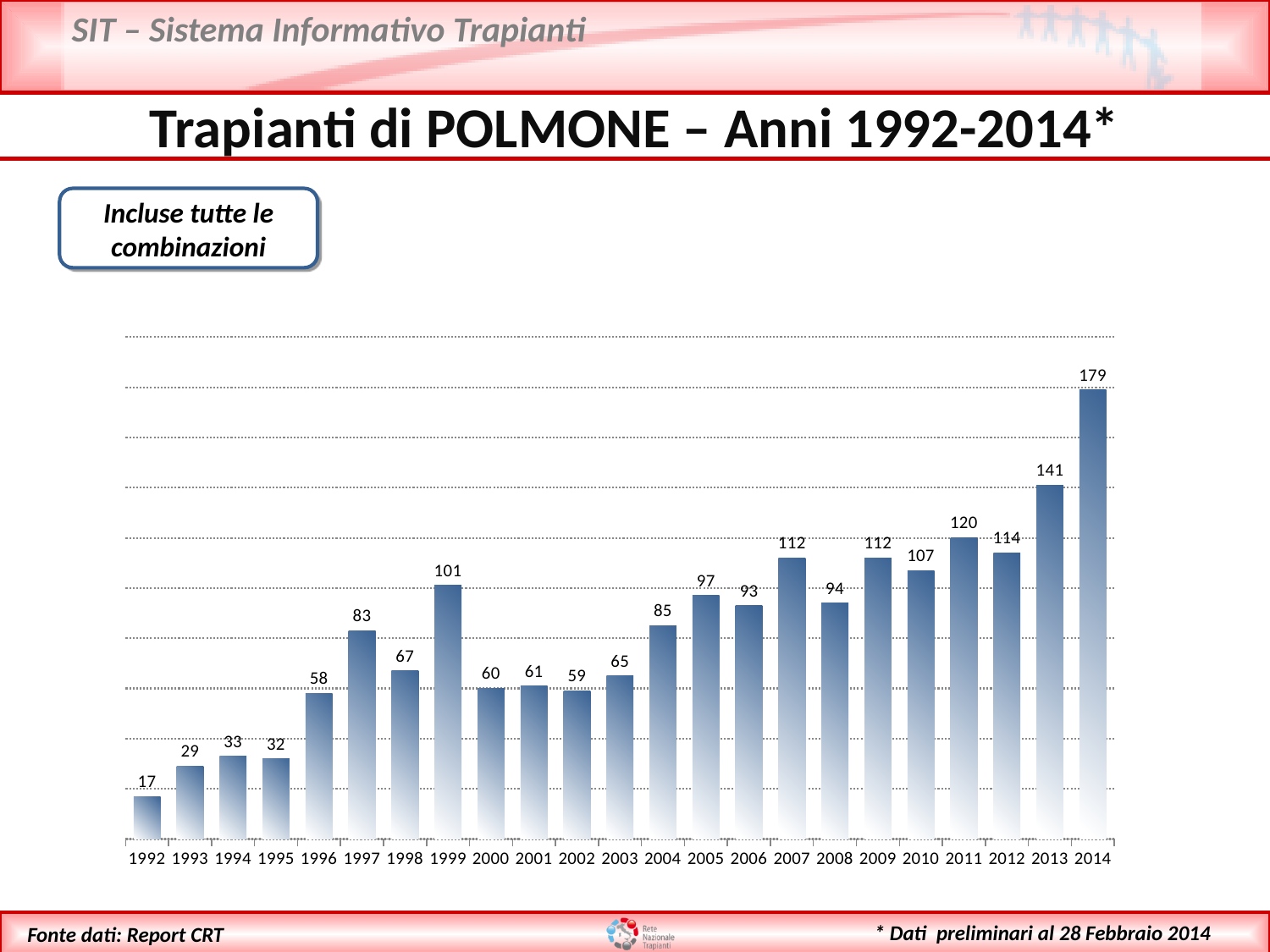
What is the difference between the values for 2011 and 2010? 13 Which year has the lowest value? 1992 What is the title of the slide containing the chart? Trapianti di POLMONE – Anni 1992-2014* What is the value for 1999? 101 What kind of chart is shown on the slide? bar chart What is the value for 2008? 94 Do the values generally rise or fall from 2009 to 2014? rise Which is larger, the value for 1997 or the value for 2004? 2004 How many years are shown on the x axis? 23 Which year has the highest value? 2014 What is the difference between the values for 2014 and 2013? 38 What is the value for 1992? 17